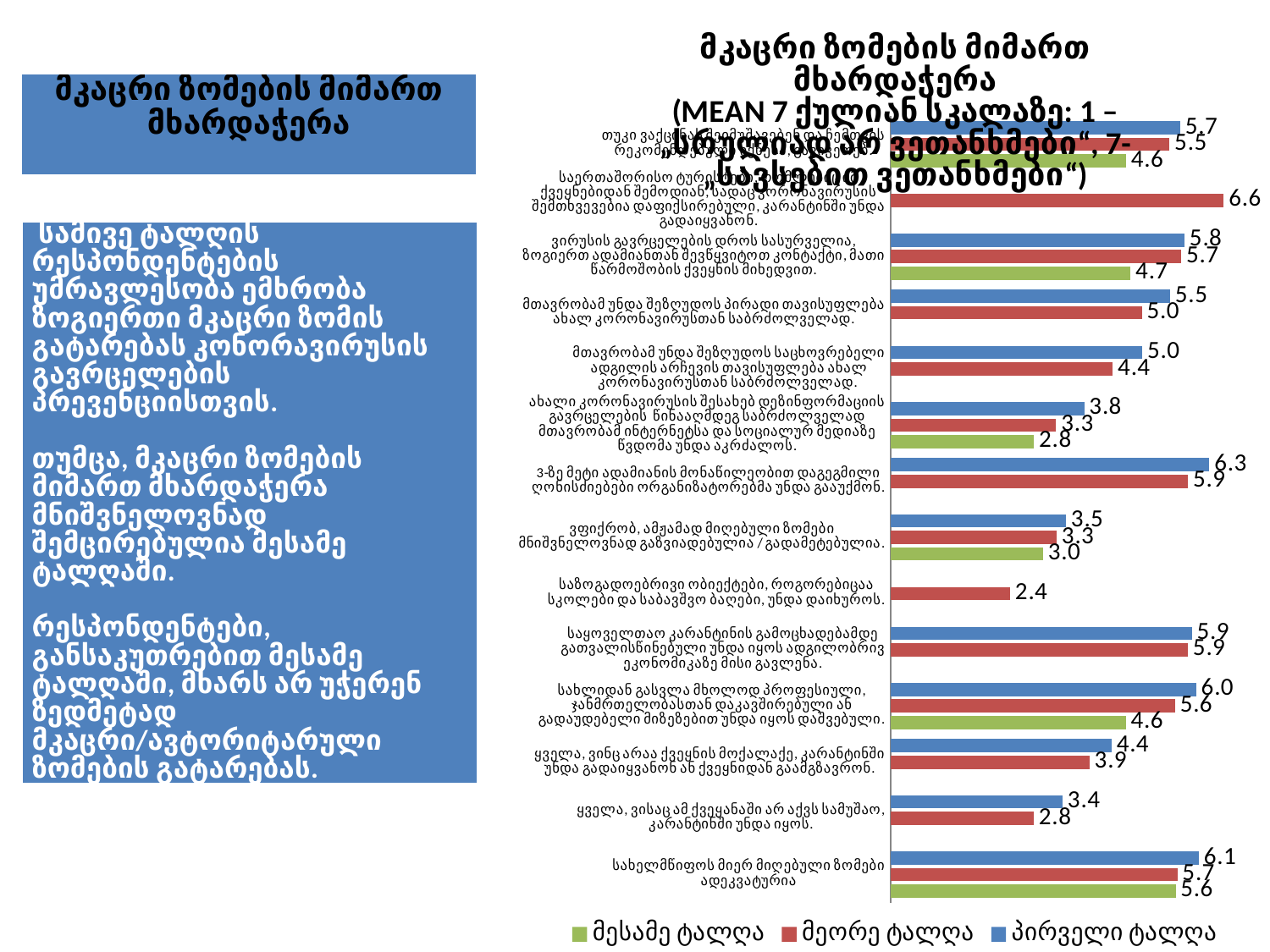
What is the value for მეორე ტალღა for the statement "საზოგადოებრივი ობიექტები, როგორებიცაა სკოლები და საბავშვო ბაღები, უნდა დაიხუროს"? 2.4 What is the value for მესამე ტალღა for the statement "ახალი კორონავირუსის შესახებ დეზინფორმაციის გავრცელების წინააღმდეგ საბრძოლველად მთავრობამ ინტერნეტსა და სოციალურ მედიაზე წვდომა უნდა აკრძალოს"? 2.8 What is the value for პირველი ტალღა for the statement "3-ზე მეტი ადამიანის მონაწილეობით დაგეგმილი ღონისძიებები ორგანიზატორებმა უნდა გააუქმონ"? 6.3 For the statement "ყველა, ვისაც ამ ქვეყანაში არ აქვს სამუშაო, კარანტინში უნდა იყოს", which is larger: პირველი ტალღა or მეორე ტალღა? პირველი ტალღა What is the difference between პირველი ტალღა and მესამე ტალღა for the statement "სახლიდან გასვლა მხოლოდ პროფესიული, ჯანმრთელობასთან დაკავშირებული ან გადაუდებელი მიზეზებით უნდა იყოს დაშვებული"? 1.4 What is the difference between პირველი ტალღა and მეორე ტალღა for the statement "მთავრობამ უნდა შეზღუდოს საცხოვრებელი ადგილის არჩევის თავისუფლება ახალ კორონავირუსთან საბრძოლველად"? 0.6 What is the value for მესამე ტალღა for the statement "სახელმწიფოს მიერ მიღებული ზომები ადეკვატურია"? 5.6 What is the value for პირველი ტალღა for the statement "სახელმწიფოს მიერ მიღებული ზომები ადეკვატურია"? 6.1 What kind of chart is shown on the slide? bar chart Which colour represents მეორე ტალღა in the chart? red What is the value for მეორე ტალღა for the statement "ვფიქრობ, ამჟამად მიღებული ზომები მნიშვნელოვნად გაზვიადებულია / გადამეტებულია"? 3.3 How many series does the chart legend list? 3